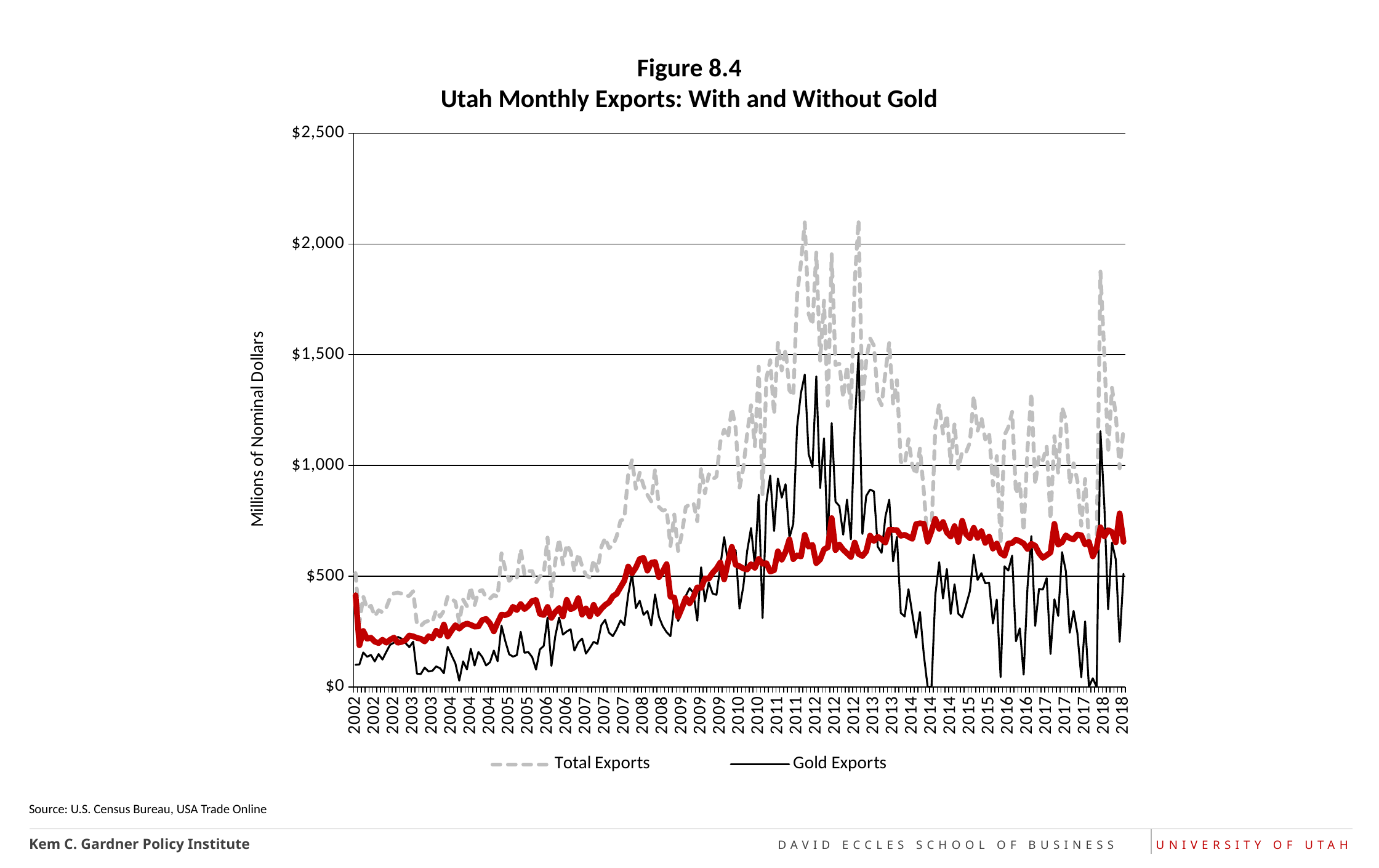
Is the highest peak of Total Exports in 2012 greater or less than $1,500? greater Is the lowest value of Gold Exports in 2014 greater or less than $500? less What is the highest value shown on the vertical axis? $2,500 What kind of chart is shown in Figure 8.4? line chart Is the value of Gold Exports at the start of 2002 greater or less than $500? less What is the title of the chart? Figure 8.4 Utah Monthly Exports: With and Without Gold How many series does the legend list? 2 In 2002, which series is higher, Total Exports or Gold Exports? Total Exports Which series reaches the highest value on the chart, Total Exports or Gold Exports? Total Exports Do Total Exports generally rise or fall from 2002 to 2012? rise What is the label on the vertical axis? Millions of Nominal Dollars